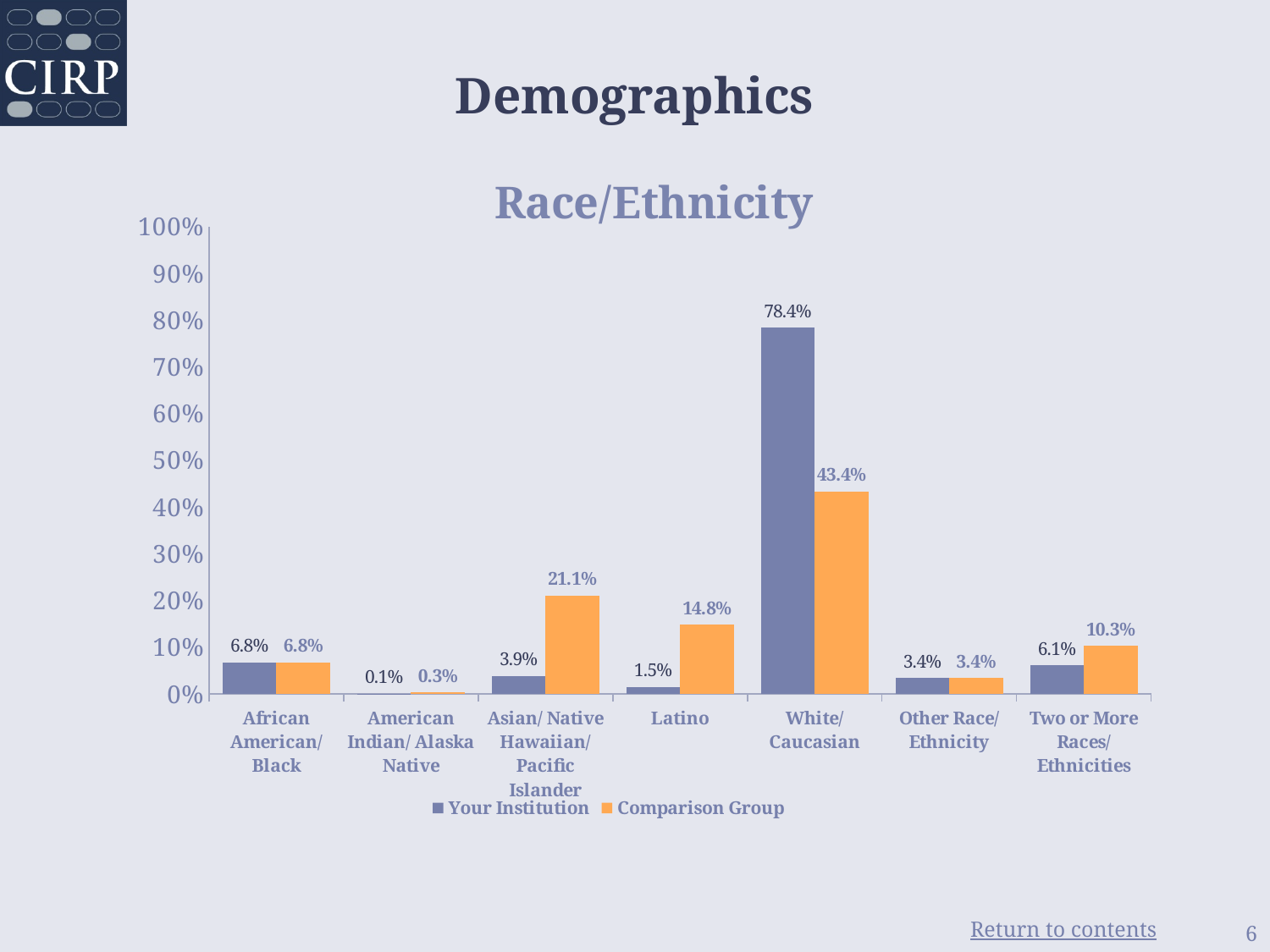
How many series does the legend list? 2 What is the Your Institution value for White/Caucasian? 78.4% What is the title of the chart? Race/Ethnicity Which is larger for Latino: the Your Institution value or the Comparison Group value? Comparison Group Which category has the lowest Comparison Group value? American Indian/Alaska Native Which category has the highest Your Institution value? White/Caucasian What is the Your Institution value for Latino? 1.5% What kind of chart is shown on the slide? Bar chart What is the Comparison Group value for Two or More Races/Ethnicities? 10.3% What is the Comparison Group value for Asian/Native Hawaiian/Pacific Islander? 21.1% How many race/ethnicity categories are shown on the x axis? 7 What is the difference between the Your Institution and Comparison Group values for White/Caucasian? 35.0%